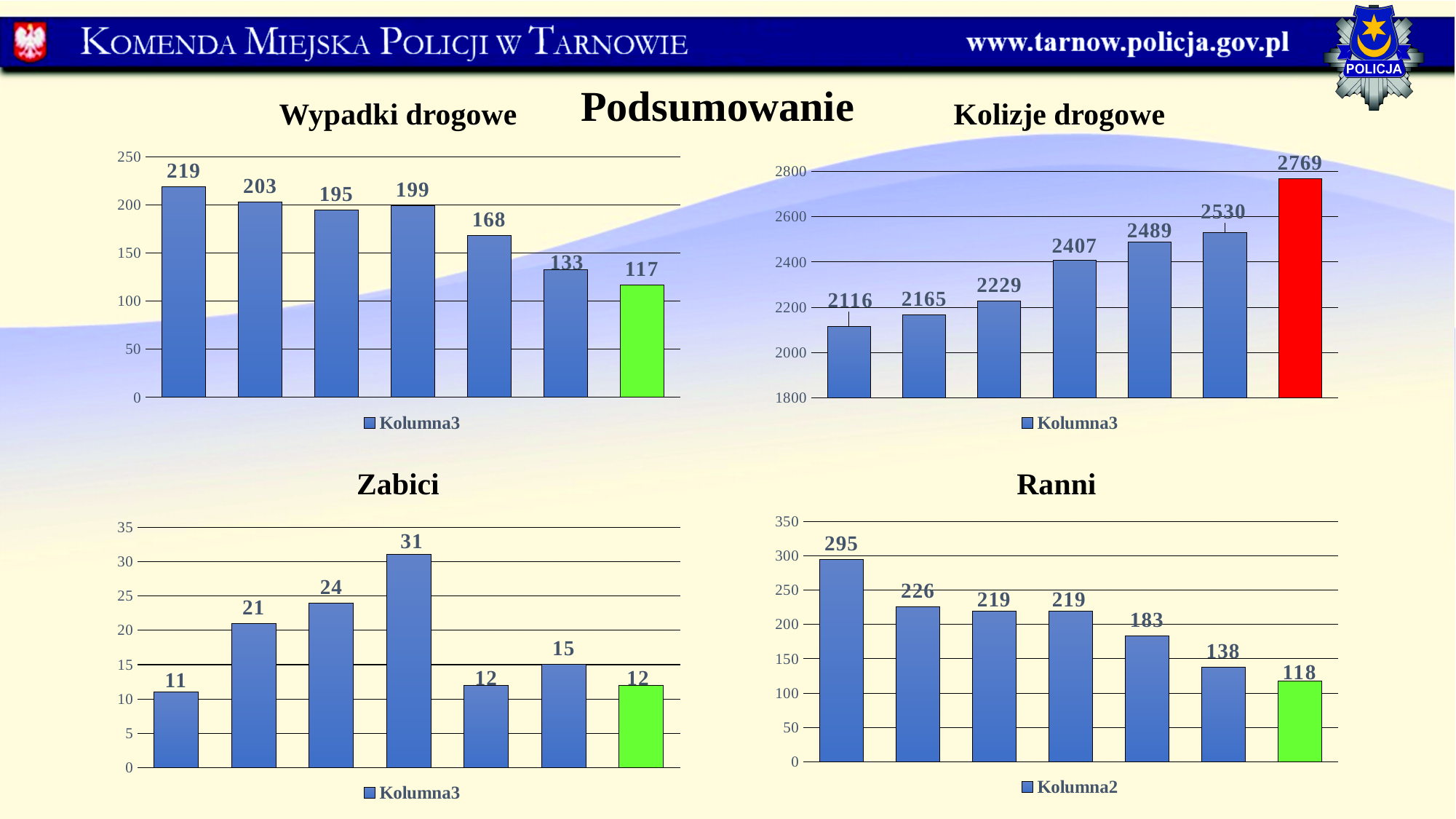
What type of chart is the "Zabici" chart? Bar chart In the "Ranni" chart, what is the difference between the first bar (295) and the last bar (118)? 177 In the "Kolizje drogowe" chart, do the values rise or fall from left to right? Rise In the "Kolizje drogowe" chart, which bar has the lowest value? The first bar (2116) In the "Wypadki drogowe" chart, what is the value of the first bar? 219 In the "Ranni" chart, how many bars are plotted? 7 In the "Zabici" chart, what is the difference between the highest bar (31) and the first bar (11)? 20 In the "Kolizje drogowe" chart, what is the value of the red bar? 2769 In the "Zabici" chart, what is the highest value shown? 31 What legend entry is shown under the "Ranni" chart? Kolumna2 In the "Wypadki drogowe" chart, is the value of the fifth bar (168) greater or less than the value of the sixth bar (133)? Greater In the "Wypadki drogowe" chart, what is the value of the last (green) bar? 117